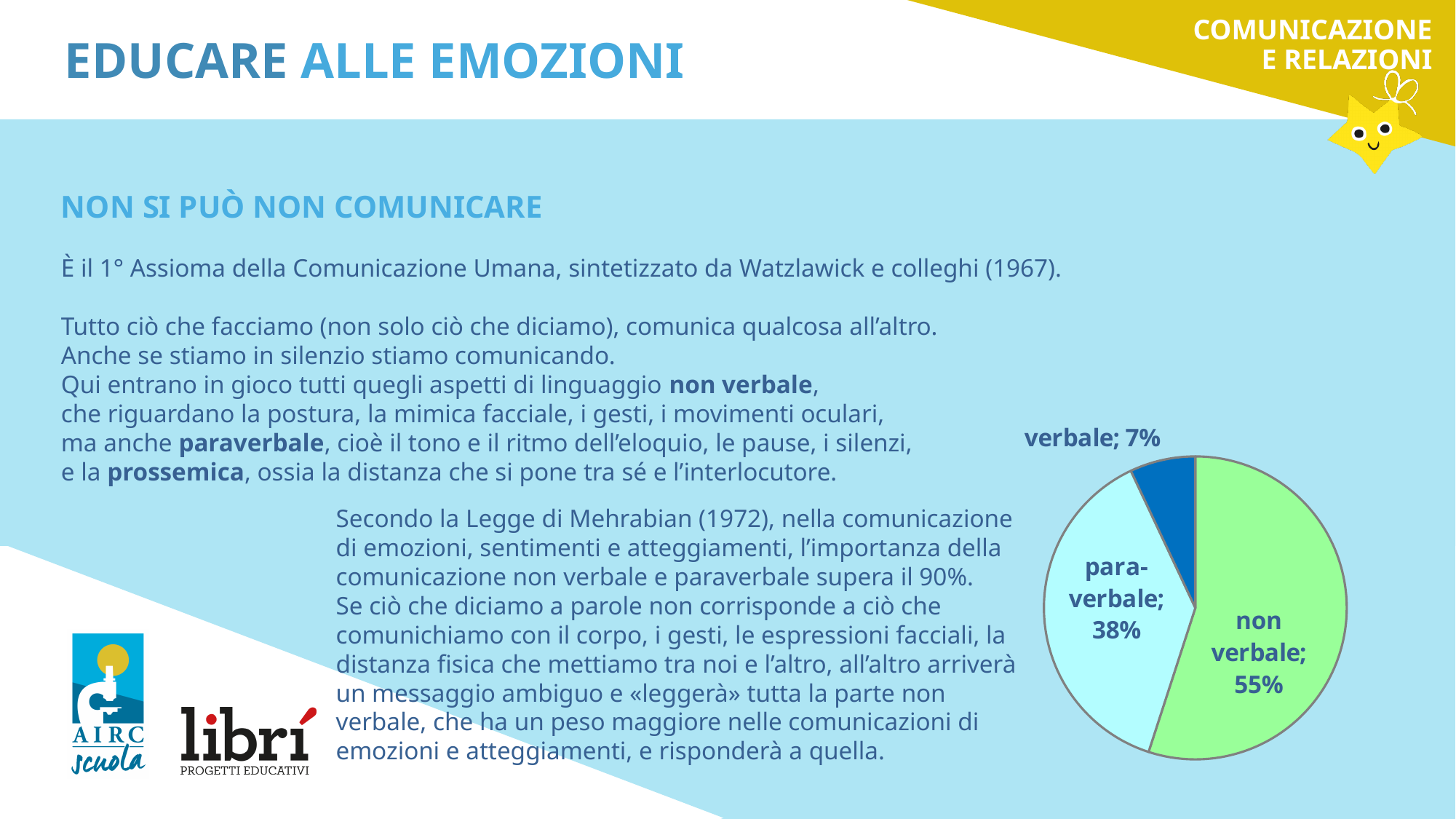
What is the combined share of 'non verbale' and 'paraverbale'? 93% What kind of chart is shown on the slide? pie chart What share of the pie does 'non verbale' have? 55% Which slice of the pie chart is the smallest? verbale Which slice of the pie chart is the largest? non verbale How many slices does the pie chart have? 3 What is the difference in percentage points between 'paraverbale' and 'verbale'? 31 What colour is the 'non verbale' slice of the pie chart? green Which is larger, the 'paraverbale' slice or the 'verbale' slice? paraverbale What is the difference in percentage points between 'non verbale' and 'paraverbale'? 17 What share of the pie does 'verbale' have? 7% What share of the pie does 'paraverbale' have? 38%